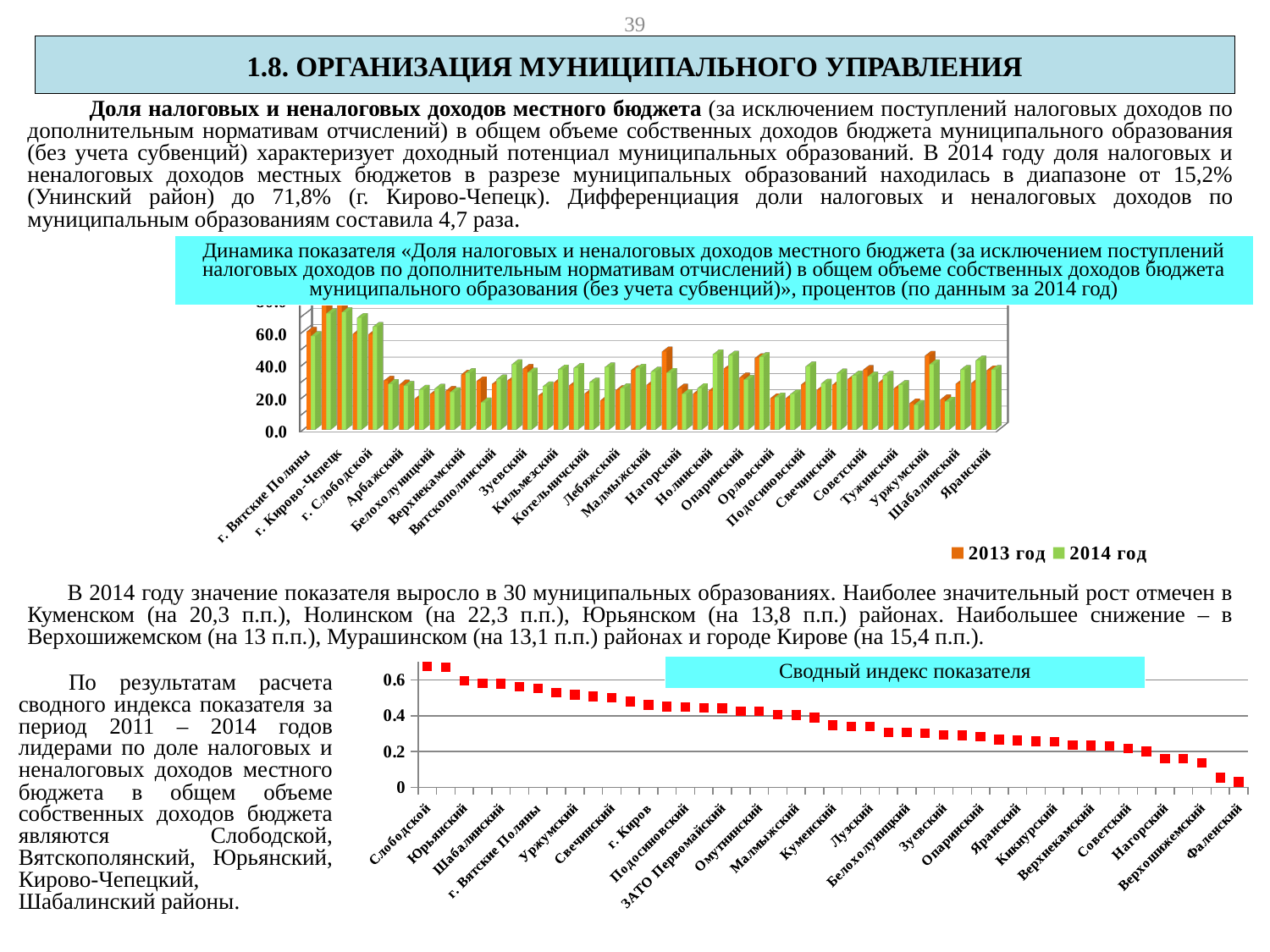
What are the two legend entries of the top chart? 2013 год, 2014 год In the bottom chart 'Сводный индекс показателя', is the value for Фаленский greater or less than 0.2? less In the bottom chart 'Сводный индекс показателя', which category has the highest value? Слободской In the bottom chart 'Сводный индекс показателя', which is larger, the value for Слободской or the value for Фаленский? Слободской In the bottom chart 'Сводный индекс показателя', which category has the lowest value? Фаленский What is the title of the bottom chart? Сводный индекс показателя In the bottom chart 'Сводный индекс показателя', is the value for Верхошижемский greater or less than 0.2? less How many series does the legend of the top chart list? 2 In the bottom chart 'Сводный индекс показателя', is the value for Слободской greater or less than 0.6? greater In the bottom chart 'Сводный индекс показателя', which is larger, the value for Юрьянский or the value for Нагорский? Юрьянский In the bottom chart 'Сводный индекс показателя', do the values rise or fall from left to right along the x axis? fall What kind of chart is the top chart on the slide (the one with the 2013 год and 2014 год legend)? bar chart